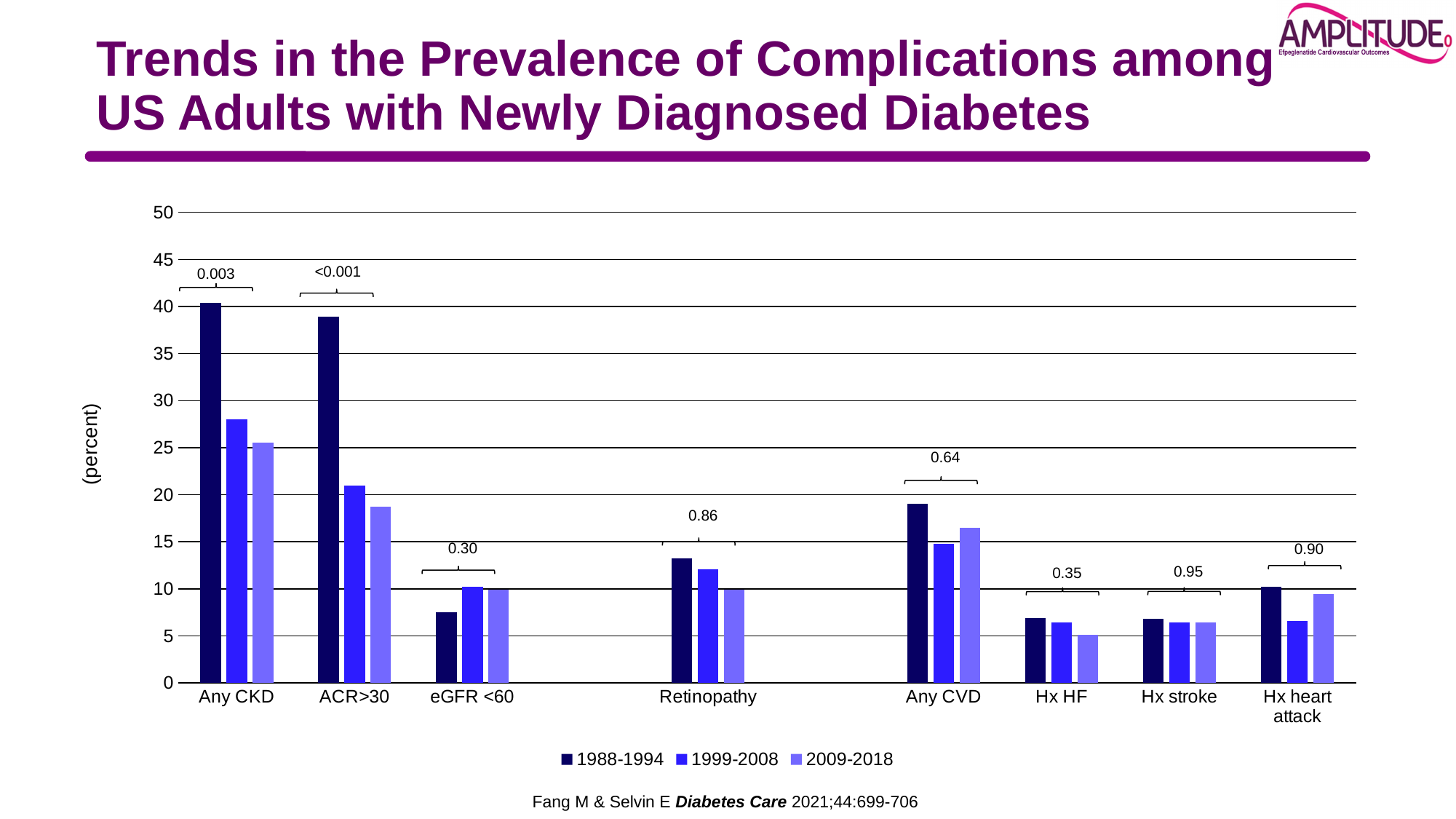
Do the values for Any CKD rise or fall from 1988-1994 to 2009-2018? fall Is the value for Any CVD in 1988-1994 greater or less than 15? greater What kind of chart is shown on the slide? bar chart How many series does the legend list? 3 Which category has the lowest bar for the 2009-2018 period? Hx HF What p-value is printed above the Any CKD bars? 0.003 Is the value for ACR>30 in 2009-2018 greater or less than 20? less How many complication categories are shown on the x axis? 8 Which is larger, the 1988-1994 value for Any CVD or the 1988-1994 value for Retinopathy? Any CVD Which category and period has the highest bar in the chart? Any CKD, 1988-1994